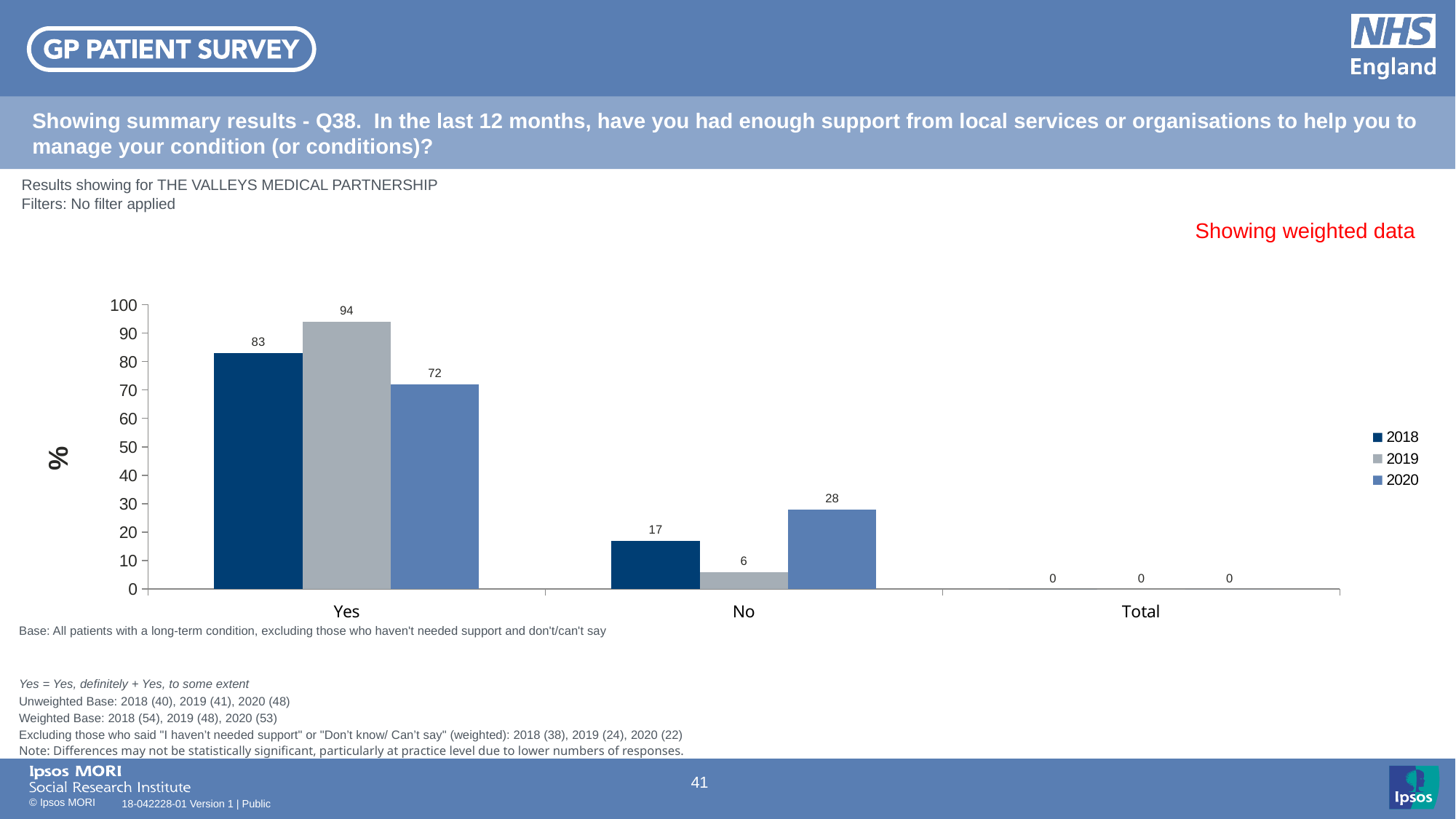
What is the difference between the 'Yes' values for 2019 and 2020? 22 What is the value for 'Yes' in 2019? 94 What is the value for 'Total' in 2020? 0 What is the label on the y axis? % How many categories are shown on the x axis? 3 What kind of chart is shown on the slide? Bar chart How many series does the legend list? 3 What is the value for 'Yes' in 2018? 83 Which is larger: the 'No' value for 2018 or for 2020? 2020 Which year has the lowest value for 'No'? 2019 Which year has the highest value for 'Yes'? 2019 What is the value for 'No' in 2020? 28